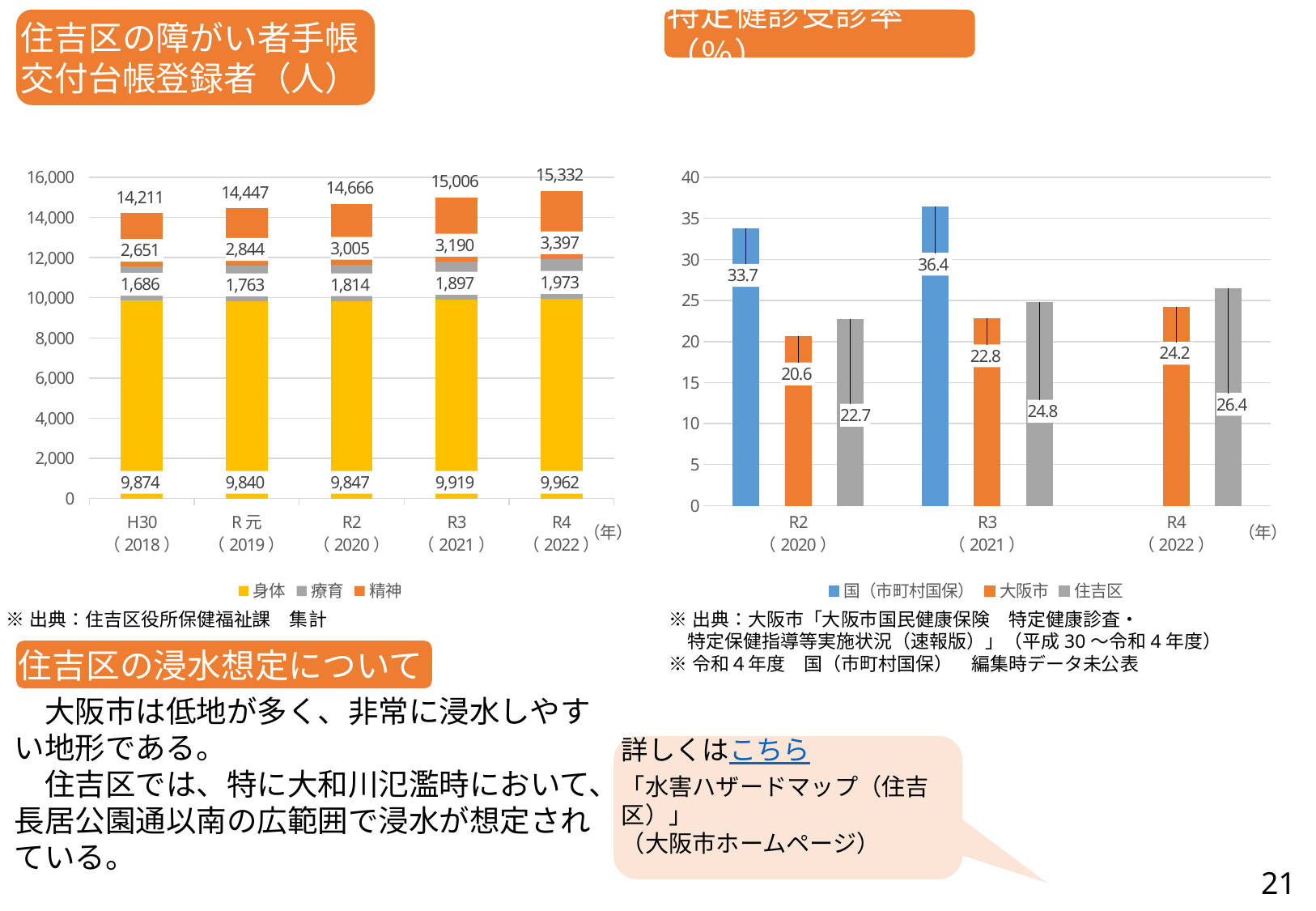
In the left chart (住吉区の障がい者手帳交付台帳登録者), what is the difference between the 精神 values in R4 (2022) and H30 (2018)? 746 In the left chart (住吉区の障がい者手帳交付台帳登録者), how many series does the legend list? 3 In the left chart (住吉区の障がい者手帳交付台帳登録者), what is the total number of registrants in R4 (2022)? 15,332 In the right chart (特定健診受診率), what is the difference between 住吉区 and 大阪市 in R3 (2021)? 2.0 In the right chart (特定健診受診率), what is the value for 国（市町村国保） in R3 (2021)? 36.4 In the left chart (住吉区の障がい者手帳交付台帳登録者), what is the value for 精神 in H30 (2018)? 2,651 In the left chart (住吉区の障がい者手帳交付台帳登録者), which year has the lowest value for 身体? R元 (2019) In the right chart (特定健診受診率), which is larger in R2 (2020): 大阪市 or 住吉区? 住吉区 In the left chart (住吉区の障がい者手帳交付台帳登録者), do the total registrant numbers rise or fall from H30 to R4? rise In the right chart (特定健診受診率), what is the value for 住吉区 in R4 (2022)? 26.4 In the left chart (住吉区の障がい者手帳交付台帳登録者), what is the value for 療育 in R3 (2021)? 1,897 What kind of chart is the right chart (特定健診受診率)? bar chart